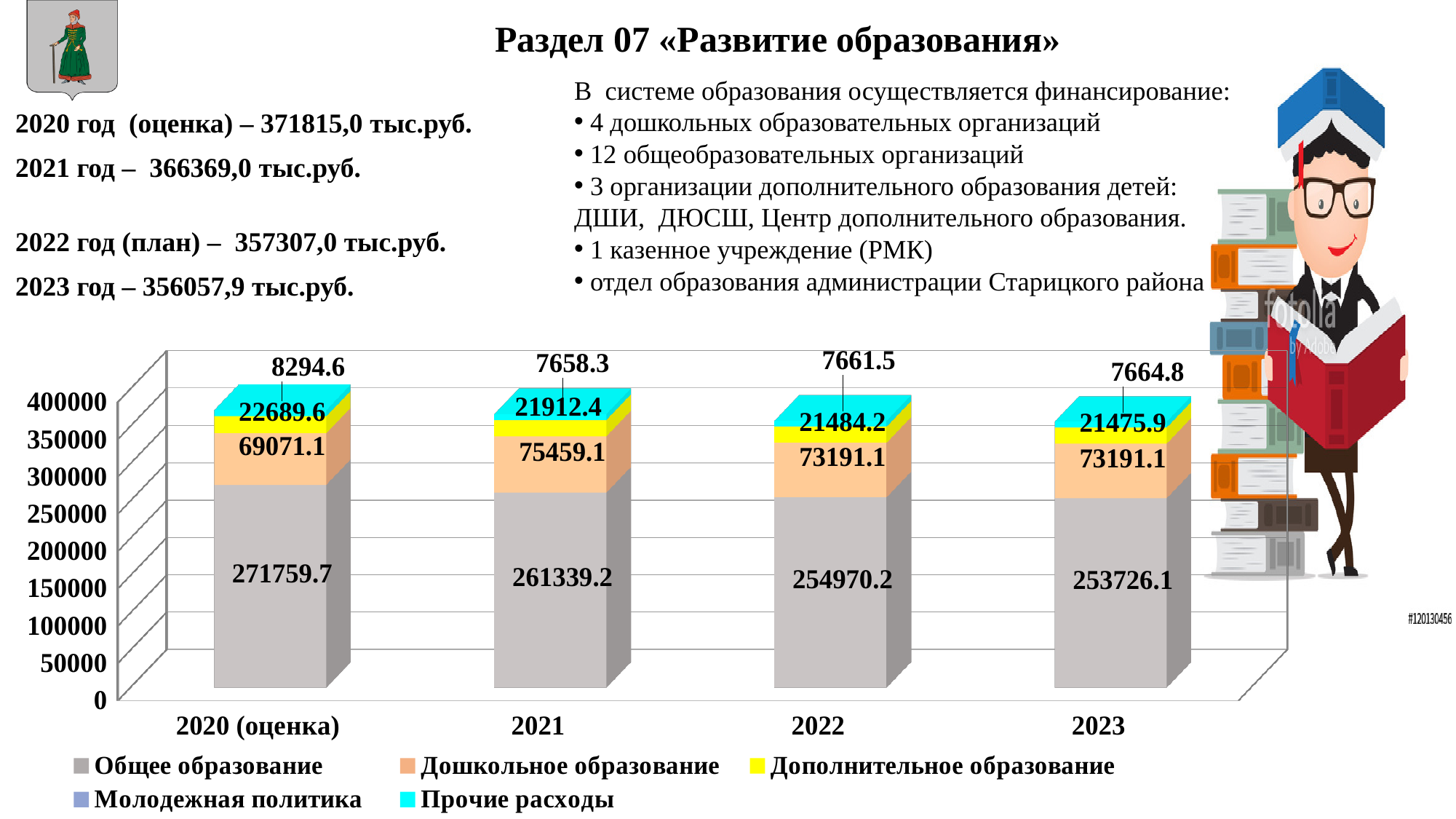
What is the difference between the Общее образование values for 2020 (оценка) and 2023? 18033.6 What is the value for Общее образование in 2021? 261339.2 Which is larger: Дополнительное образование in 2020 (оценка) or in 2021? 2020 (оценка) In which year is the value for Общее образование the highest? 2020 (оценка) How many categories (years) are shown on the x axis of the chart? 4 Does the value for Общее образование rise or fall from 2020 (оценка) to 2023? Fall In which year is the value for Дошкольное образование the lowest? 2020 (оценка) What is the value for Дополнительное образование in 2022? 21484.2 What type of chart is shown on the slide? Stacked bar chart What is the value for Прочие расходы in 2023? 7664.8 How many series does the chart legend list? 5 What is the value for Дошкольное образование in 2020 (оценка)? 69071.1